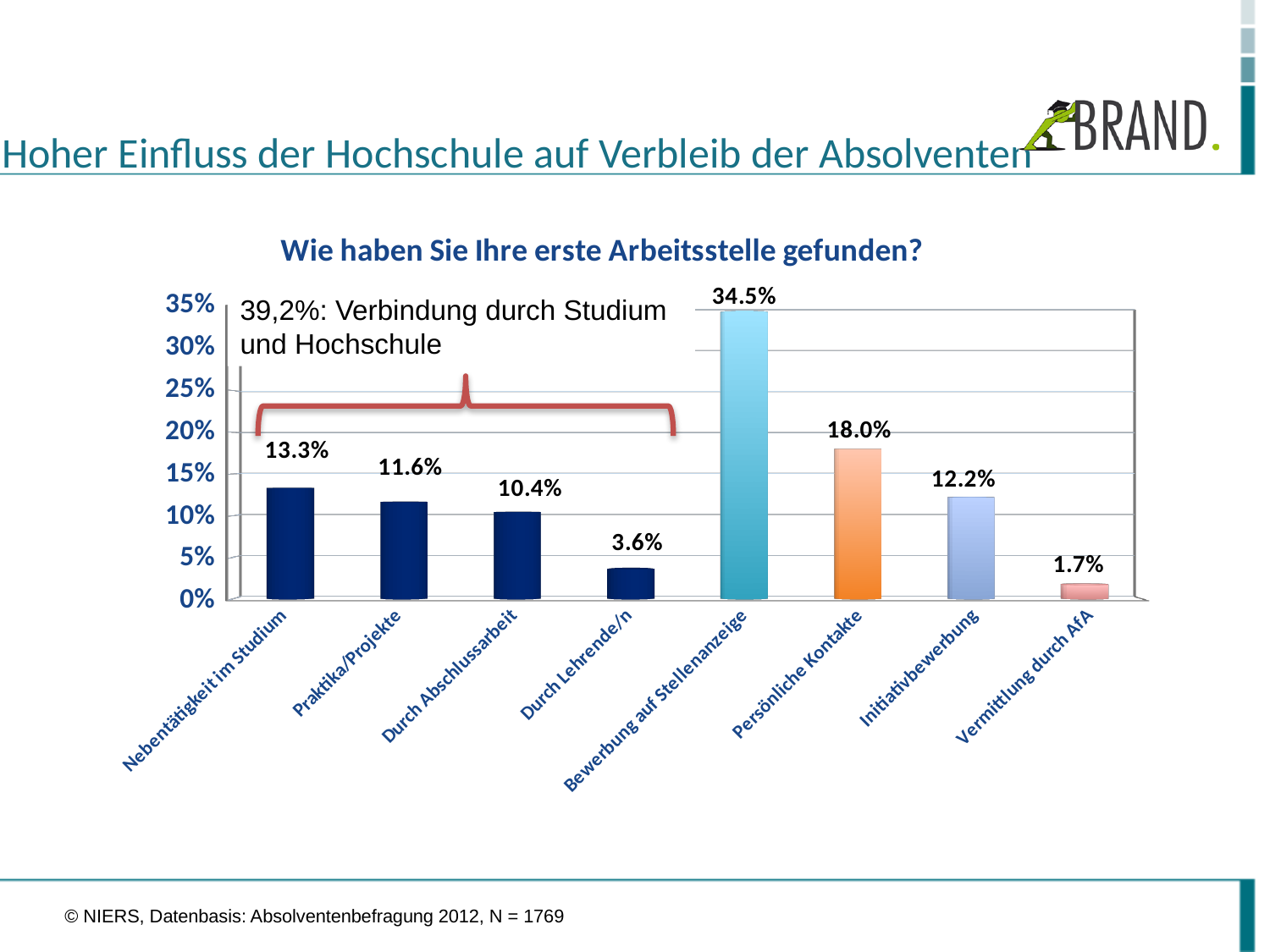
Is the value for 'Durch Abschlussarbeit' greater or less than 15%? less What percentage of respondents found their first job through 'Bewerbung auf Stellenanzeige'? 34.5% What is the difference between the values for 'Bewerbung auf Stellenanzeige' and 'Persönliche Kontakte'? 16.5% What kind of chart is shown on the slide? bar chart What is the value shown for 'Initiativbewerbung'? 12.2% How many categories are shown in the chart? 8 Which is larger: the value for 'Nebentätigkeit im Studium' or for 'Praktika/Projekte'? Nebentätigkeit im Studium What is the value shown for 'Durch Lehrende/n'? 3.6% What is the title of the chart? Wie haben Sie Ihre erste Arbeitsstelle gefunden? Which category has the highest value in the chart? Bewerbung auf Stellenanzeige Which category has the lowest value in the chart? Vermittlung durch AfA What is the value shown for 'Persönliche Kontakte'? 18.0%